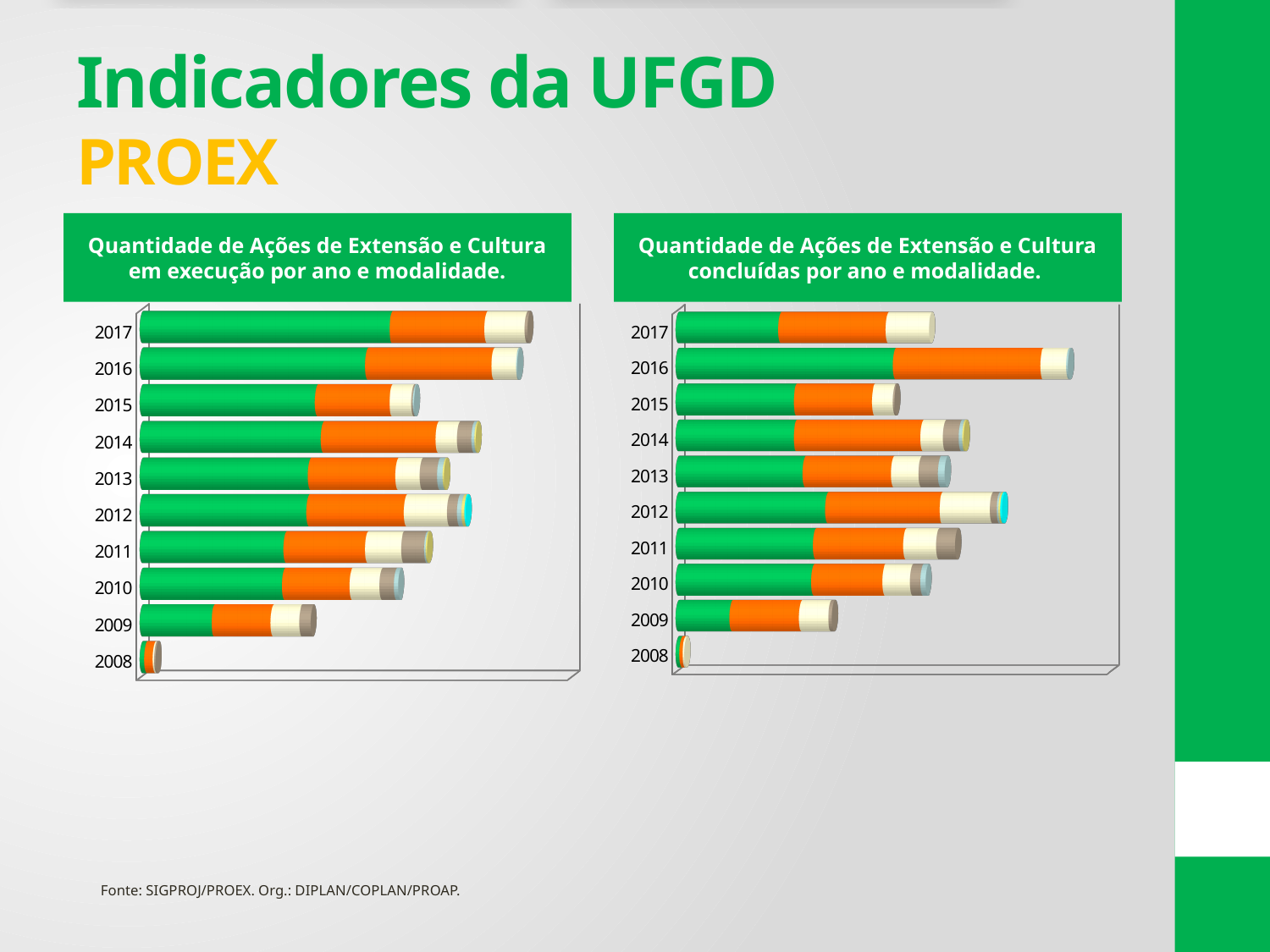
In the right chart, 'Quantidade de Ações de Extensão e Cultura concluídas por ano e modalidade', which year has the longer bar, 2016 or 2017? 2016 In the right chart, 'Quantidade de Ações de Extensão e Cultura concluídas por ano e modalidade', which year has the longer bar, 2009 or 2010? 2010 In the left chart, 'Quantidade de Ações de Extensão e Cultura em execução por ano e modalidade', which year has the longer bar, 2014 or 2015? 2014 What is the earliest year shown on the left chart, 'Quantidade de Ações de Extensão e Cultura em execução por ano e modalidade'? 2008 What is the title of the right chart on the slide? Quantidade de Ações de Extensão e Cultura concluídas por ano e modalidade. In the left chart, 'Quantidade de Ações de Extensão e Cultura em execução por ano e modalidade', which year has the shortest bar? 2008 In the right chart, 'Quantidade de Ações de Extensão e Cultura concluídas por ano e modalidade', which year has the shortest bar? 2008 How many years are shown on the right chart, 'Quantidade de Ações de Extensão e Cultura concluídas por ano e modalidade'? 10 In the right chart, 'Quantidade de Ações de Extensão e Cultura concluídas por ano e modalidade', which year has the longest bar? 2016 What kind of chart is the left chart, 'Quantidade de Ações de Extensão e Cultura em execução por ano e modalidade'? Bar chart How many years are shown on the left chart, 'Quantidade de Ações de Extensão e Cultura em execução por ano e modalidade'? 10